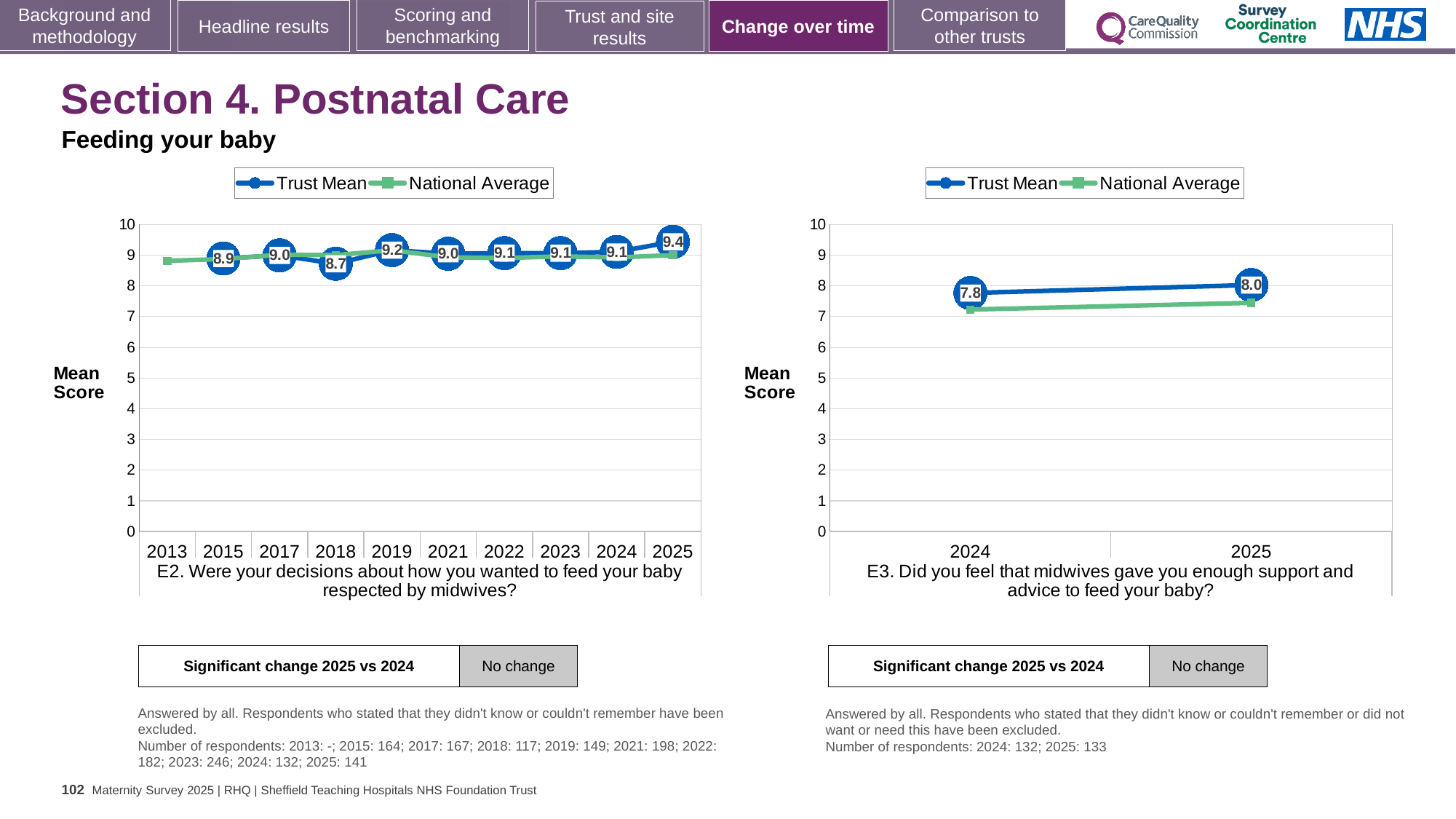
In the E2 chart on the left, what is the Trust Mean for 2018? 8.7 In the E2 chart on the left, what is the Trust Mean for 2025? 9.4 In the E3 chart on the right, what is the Trust Mean for 2025? 8.0 In the E2 chart on the left, is the Trust Mean for 2019 greater or less than 9? greater In the E2 chart on the left, what is the difference between the Trust Mean for 2025 and the Trust Mean for 2024? 0.3 In the E2 chart on the left, which year has the lowest labelled Trust Mean? 2018 How many series does the legend of the E3 chart on the right list? 2 In the E2 chart on the left, which year has the highest Trust Mean? 2025 What kind of chart is the E2 chart on the left? Line chart In the E3 chart on the right, is the National Average for 2024 greater or less than 8? less In the E3 chart on the right, what is the Trust Mean for 2024? 7.8 In the E3 chart on the right, is the Trust Mean higher in 2024 or 2025? 2025